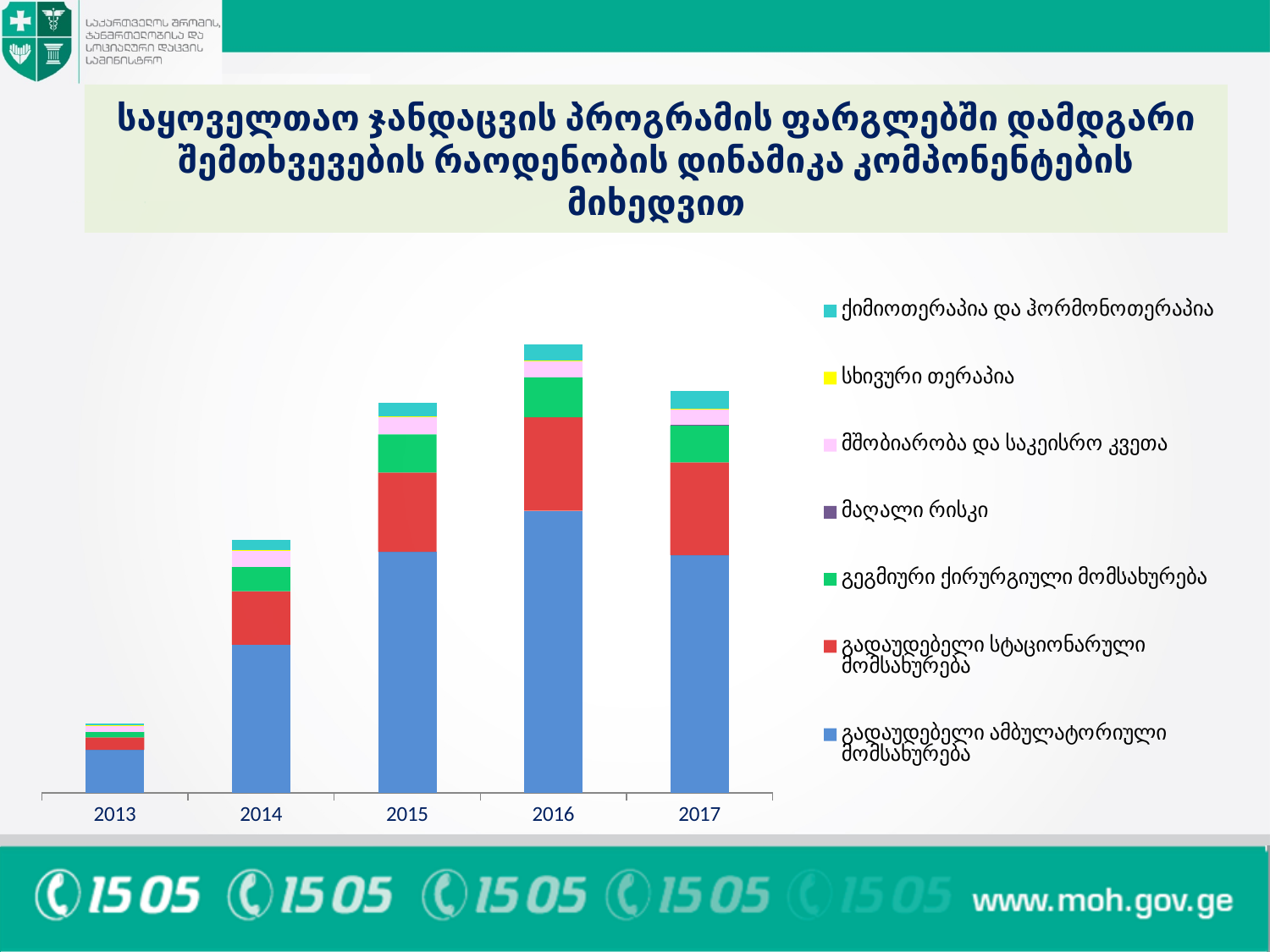
How many series does the chart's legend list? 7 Which series forms the largest segment of the 2016 bar? გადაუდებელი ამბულატორიული მომსახურება Which year has the shortest stacked bar? 2013 What is the first year shown on the x axis? 2013 Do the total bar heights rise or fall from 2013 to 2016? Rise How many years are shown on the x axis of the chart? 5 Does the total bar height rise or fall from 2016 to 2017? Fall What kind of chart is shown on the slide? Stacked bar chart Which year has the taller stacked bar, 2014 or 2015? 2015 Which year has the tallest stacked bar? 2016 Which legend entry is shown in yellow? სხივური თერაპია Which year has the taller stacked bar, 2017 or 2016? 2016